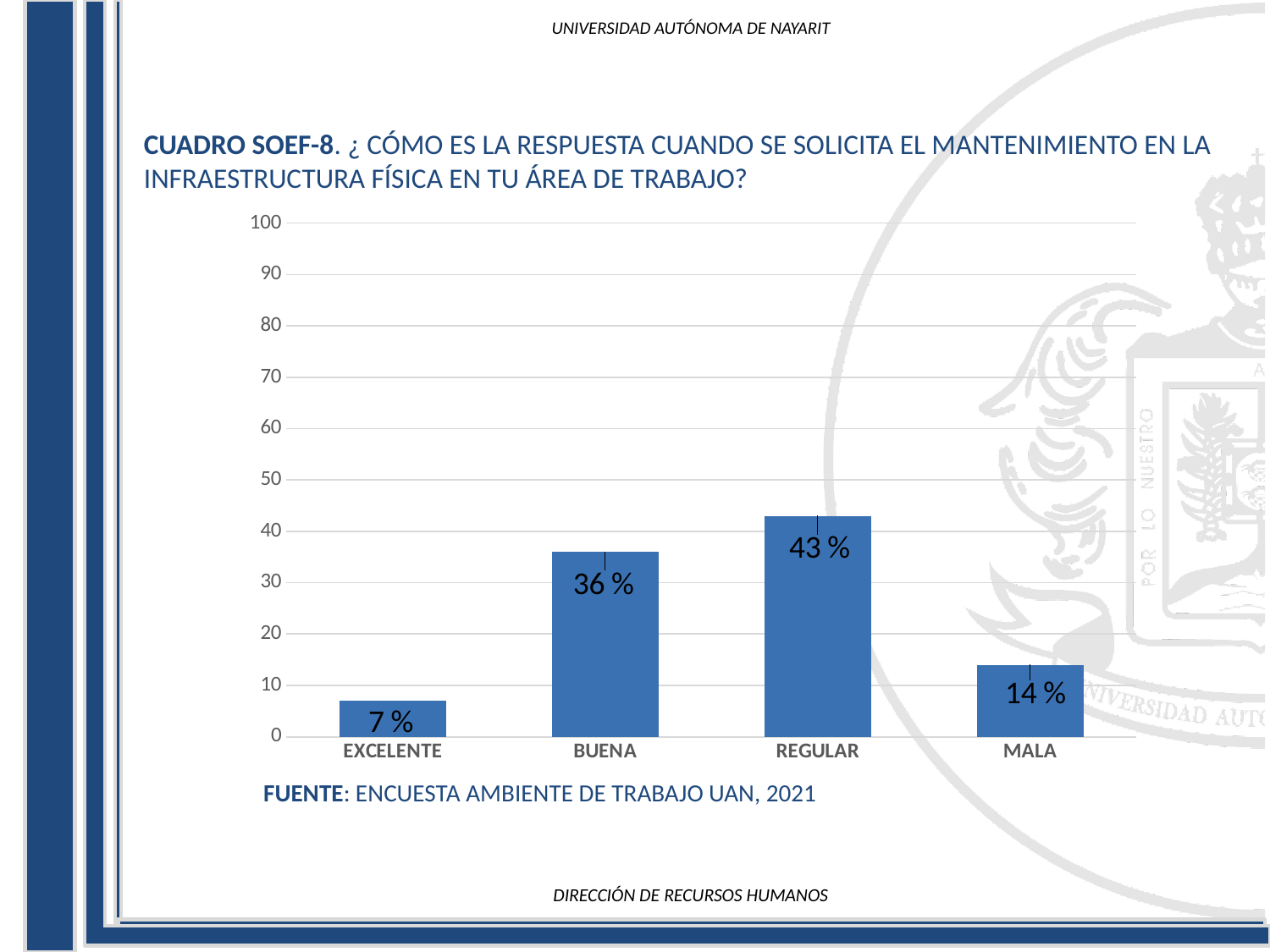
What is the value for BUENA? 36 % What is the value for EXCELENTE? 7 % Is the value for REGULAR greater or less than 40? greater Which category has the lowest value? EXCELENTE Which category has the highest value? REGULAR What kind of chart is shown on the slide? bar chart What is the difference between the values for MALA and EXCELENTE? 7 % How many categories are shown on the x axis? 4 What is the value for MALA? 14 % What is the value for REGULAR? 43 % What is the difference between the values for REGULAR and BUENA? 7 % Which is larger, the value for BUENA or the value for MALA? BUENA